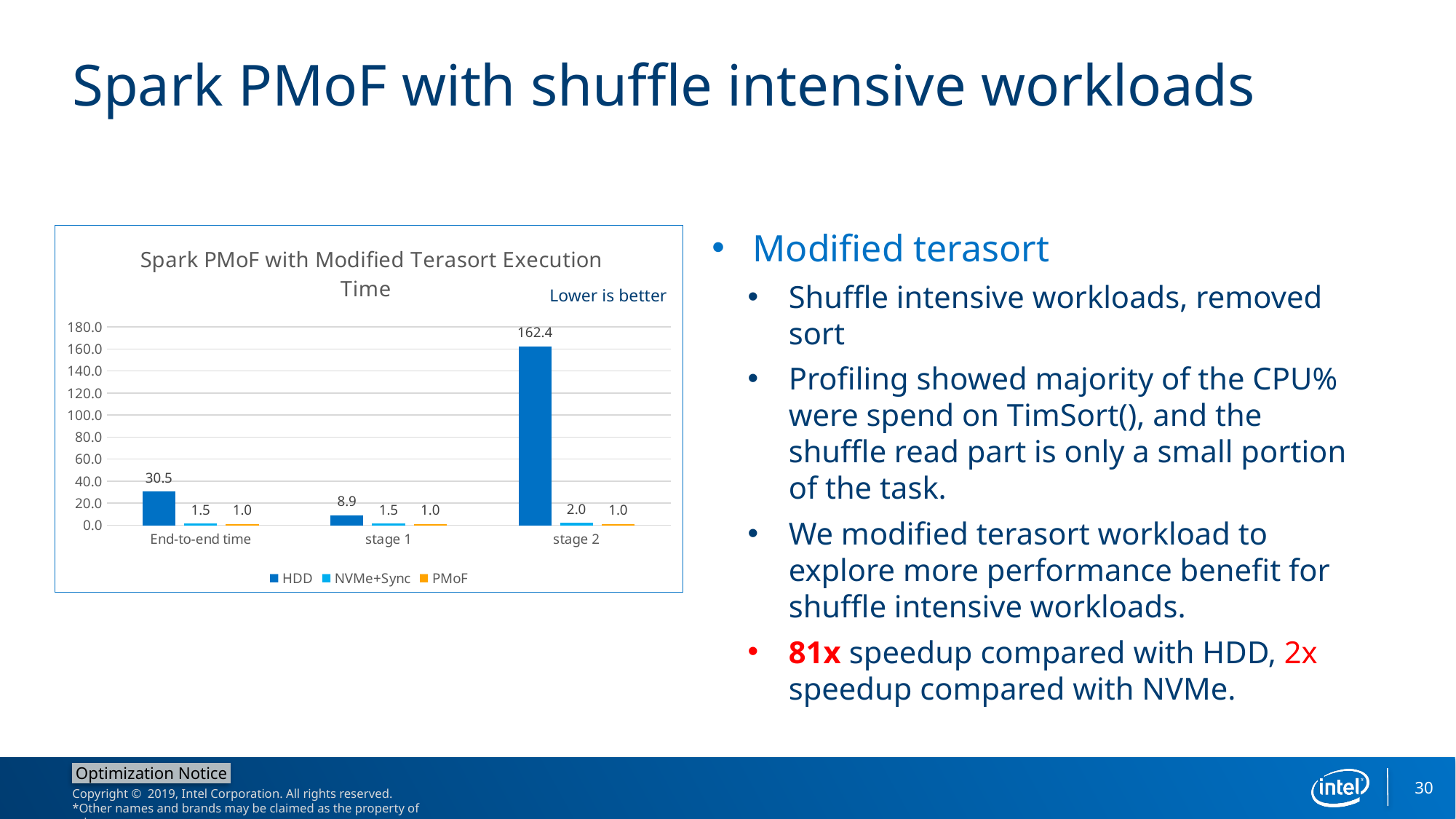
What is the HDD value for stage 2? 162.4 What is the difference between the HDD and PMoF values for stage 2? 161.4 What is the NVMe+Sync value for stage 2? 2.0 What is the difference between the HDD values for stage 2 and End-to-end time? 131.9 Which is larger for End-to-end time, the HDD value or the NVMe+Sync value? HDD How many categories are shown on the x axis? 3 Which category has the lowest HDD value? stage 1 What kind of chart is shown on the slide? bar chart How many series does the legend list? 3 Which category has the highest HDD value? stage 2 What is the HDD value for End-to-end time? 30.5 What is the HDD value for stage 1? 8.9